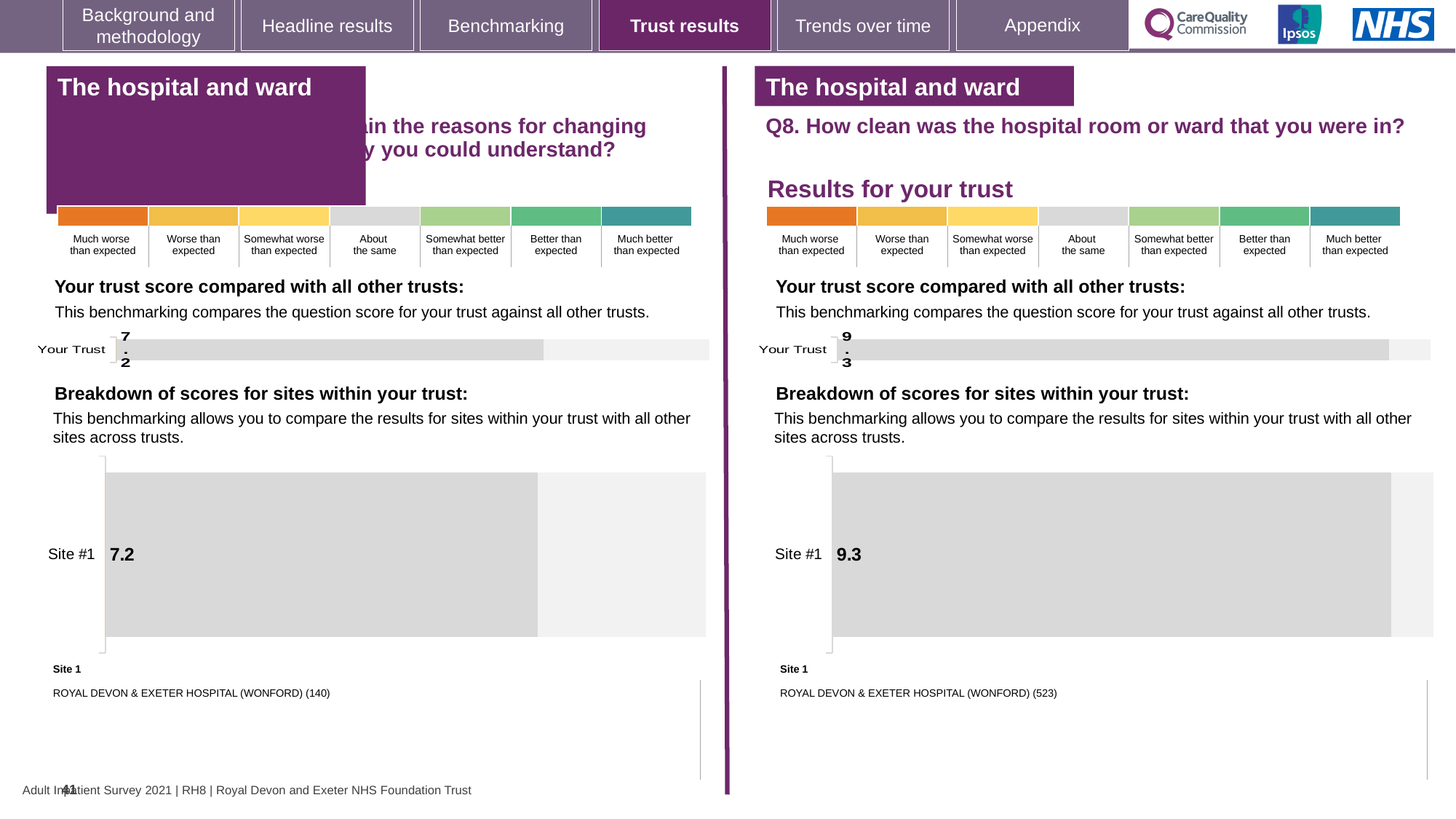
On the right-hand side of the slide (Q8), which site is named as Site 1? ROYAL DEVON & EXETER HOSPITAL (WONFORD) (523) On the left-hand side of the slide, what score is shown for Site #1 in the breakdown of scores for sites within your trust? 7.2 On the right-hand side of the slide (Q8), what score is shown for Site #1 in the breakdown of scores for sites within your trust? 9.3 Which is larger: the Your Trust score on the left-hand side of the slide or the Your Trust score on the right-hand side (Q8)? Right-hand side (Q8) How many sites are listed in the breakdown of scores for sites within your trust on the right-hand side of the slide (Q8)? 1 On the right-hand side of the slide (Q8), is the Your Trust score the same as the Site #1 score? Yes What is the difference between the Site #1 score on the right-hand side (Q8) and the Site #1 score on the left-hand side of the slide? 2.1 On the left-hand side of the slide, what is the score shown for Your Trust? 7.2 How many sites are listed in the breakdown of scores for sites within your trust on the left-hand side of the slide? 1 On the left-hand side of the slide, which site is named as Site 1? ROYAL DEVON & EXETER HOSPITAL (WONFORD) (140) What kind of chart is used to show the Site #1 score on the right-hand side of the slide (Q8)? Bar chart On the right-hand side of the slide (Q8, how clean was the hospital room or ward), what is the score shown for Your Trust? 9.3